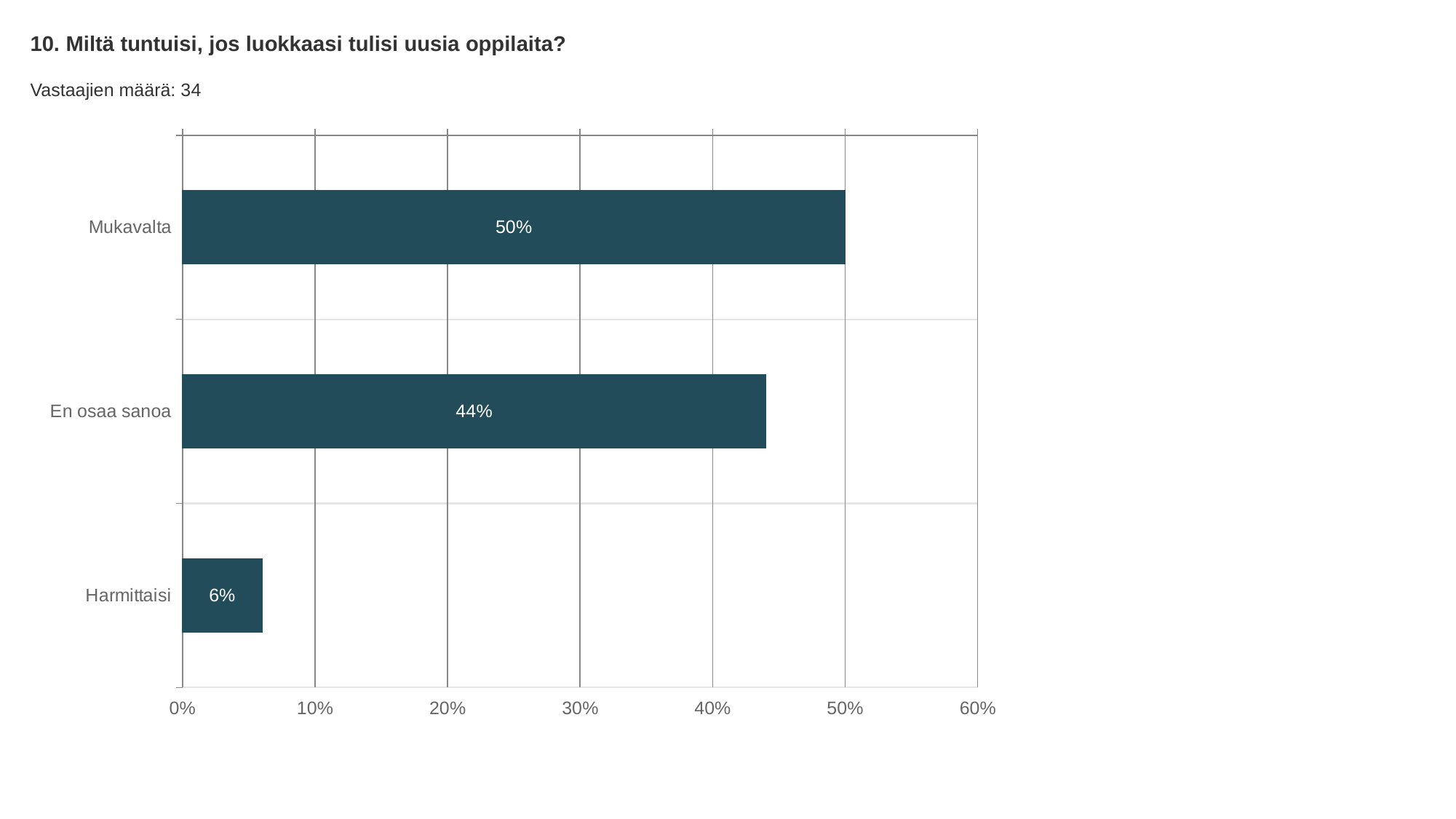
What is the value shown for "En osaa sanoa"? 44% How many respondents (Vastaajien määrä) are reported on the slide? 34 What is the difference in percentage points between "Mukavalta" and "En osaa sanoa"? 6 What is the value shown for "Harmittaisi"? 6% What kind of chart is shown on the slide? Bar chart Which category has the lowest value? Harmittaisi Is the value for "En osaa sanoa" greater or less than 40%? greater What percentage of respondents answered "Mukavalta"? 50% Which is larger, the value for "En osaa sanoa" or the value for "Harmittaisi"? En osaa sanoa What is the difference in percentage points between "En osaa sanoa" and "Harmittaisi"? 38 How many categories are shown in the chart? 3 Which category has the highest value? Mukavalta